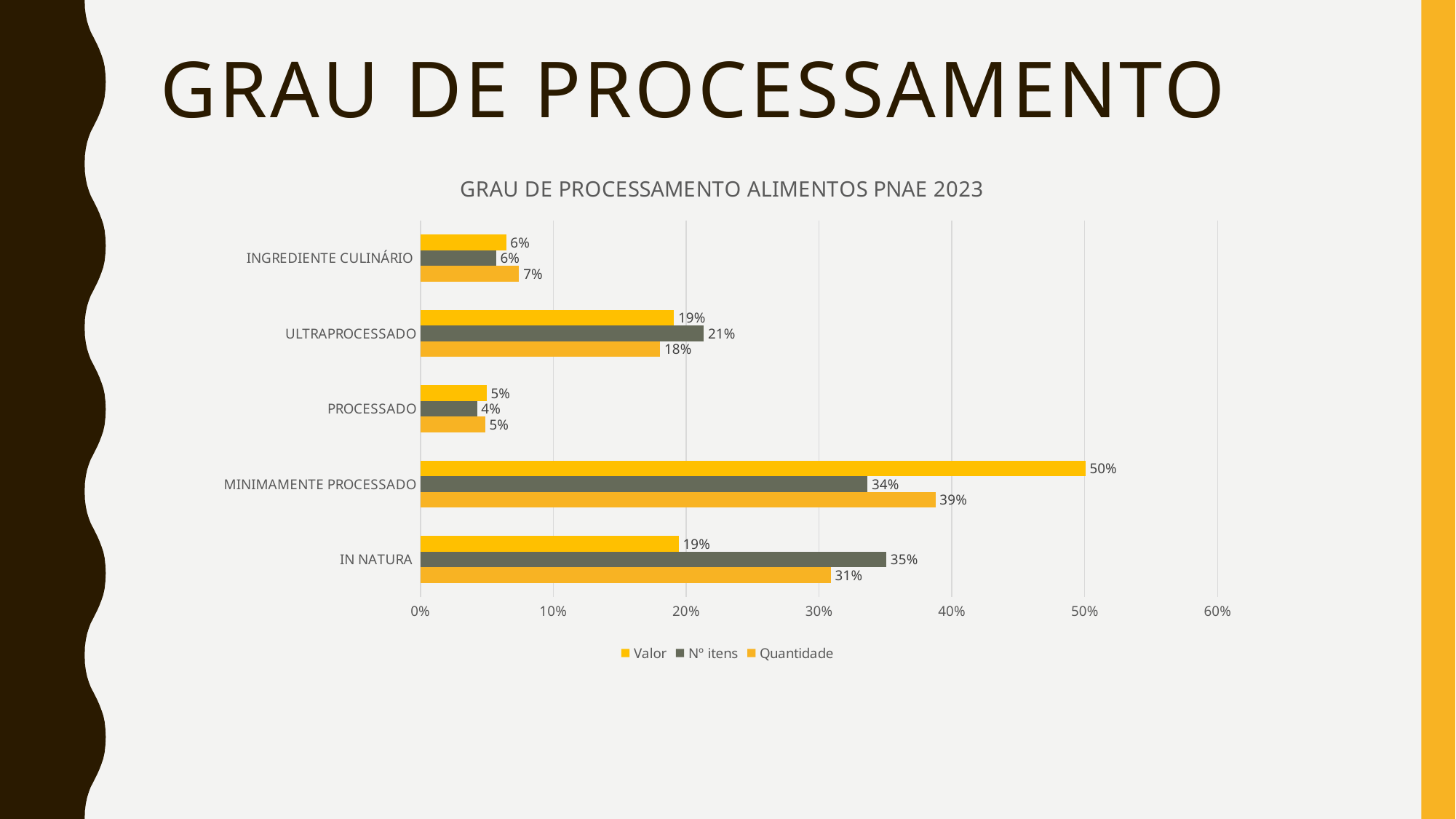
What is the difference between the Nº itens values for IN NATURA and ULTRAPROCESSADO? 14 percentage points Which category has the highest Nº itens value? IN NATURA Which category has the single longest bar in the chart? MINIMAMENTE PROCESSADO What is the Nº itens value for ULTRAPROCESSADO? 21% What is the title of the chart? GRAU DE PROCESSAMENTO ALIMENTOS PNAE 2023 What is the Nº itens value for MINIMAMENTE PROCESSADO? 34% Which category has the lowest Nº itens value? PROCESSADO How many categories are shown on the vertical axis of the chart? 5 What kind of chart is shown on the slide? Bar chart How many series does the legend of the chart list? 3 Is the Nº itens value for INGREDIENTE CULINÁRIO greater or less than 10%? less What is the Nº itens value for IN NATURA? 35%